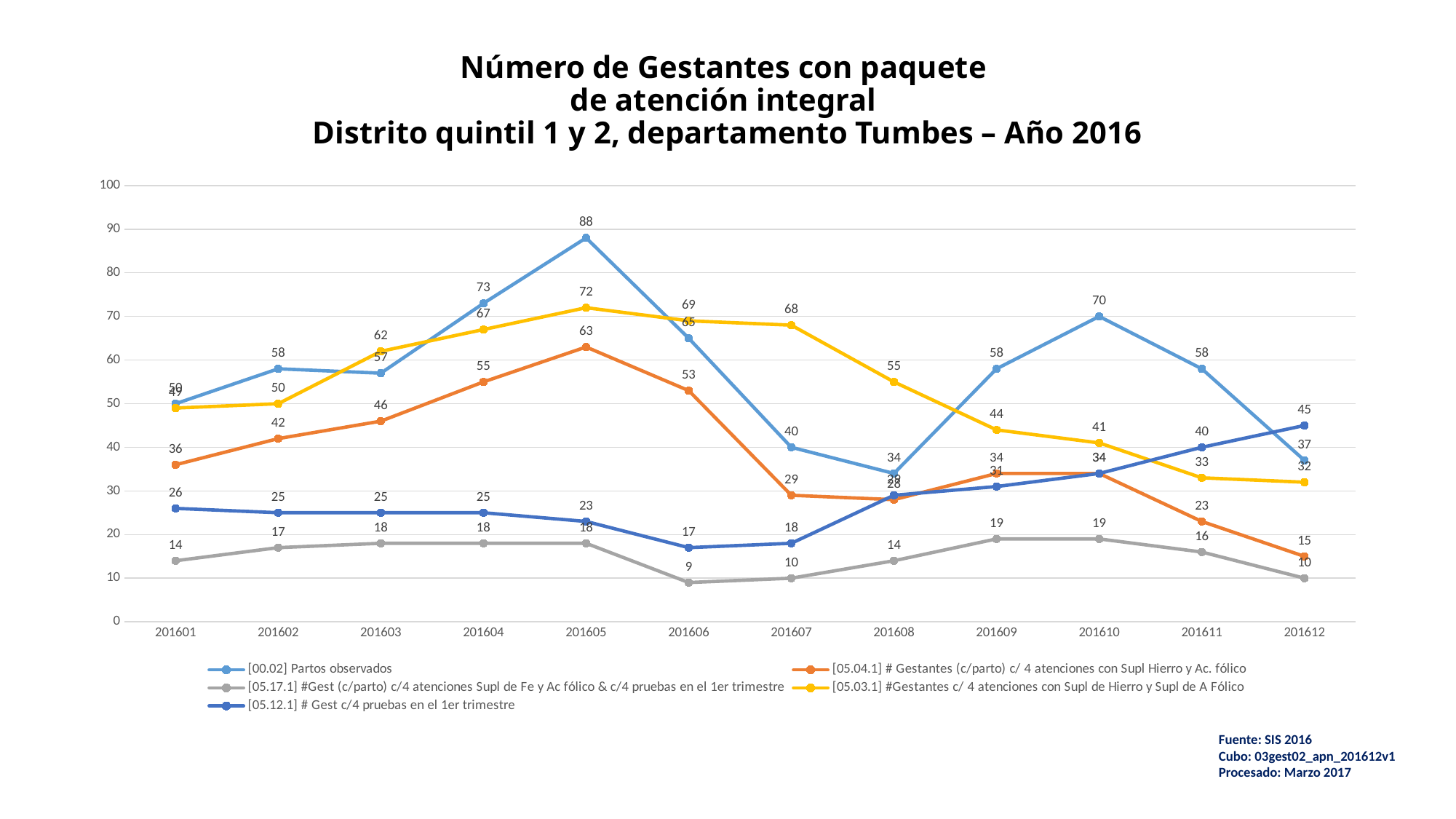
What colour is the line for [05.03.1] #Gestantes c/ 4 atenciones con Supl de Hierro y Supl de A Fólico? yellow What is the value of [05.12.1] # Gest c/4 pruebas en el 1er trimestre in 201612? 45 What is the value of [05.03.1] #Gestantes c/ 4 atenciones con Supl de Hierro y Supl de A Fólico in 201607? 68 How many months are plotted along the x axis? 12 Does [05.12.1] # Gest c/4 pruebas en el 1er trimestre rise or fall from 201608 to 201612? rise How many series does the legend list? 5 In which month does [00.02] Partos observados reach its highest value? 201605 What is the difference between [00.02] Partos observados and [05.04.1] # Gestantes (c/parto) c/ 4 atenciones con Supl Hierro y Ac. fólico in 201605? 25 What type of chart is shown on the slide? line chart In which month does [05.17.1] #Gest (c/parto) c/4 atenciones Supl de Fe y Ac fólico & c/4 pruebas en el 1er trimestre reach its lowest value? 201606 What is the value of [00.02] Partos observados in 201605? 88 Which is larger in 201611: [05.12.1] # Gest c/4 pruebas en el 1er trimestre or [05.04.1] # Gestantes (c/parto) c/ 4 atenciones con Supl Hierro y Ac. fólico? [05.12.1] # Gest c/4 pruebas en el 1er trimestre